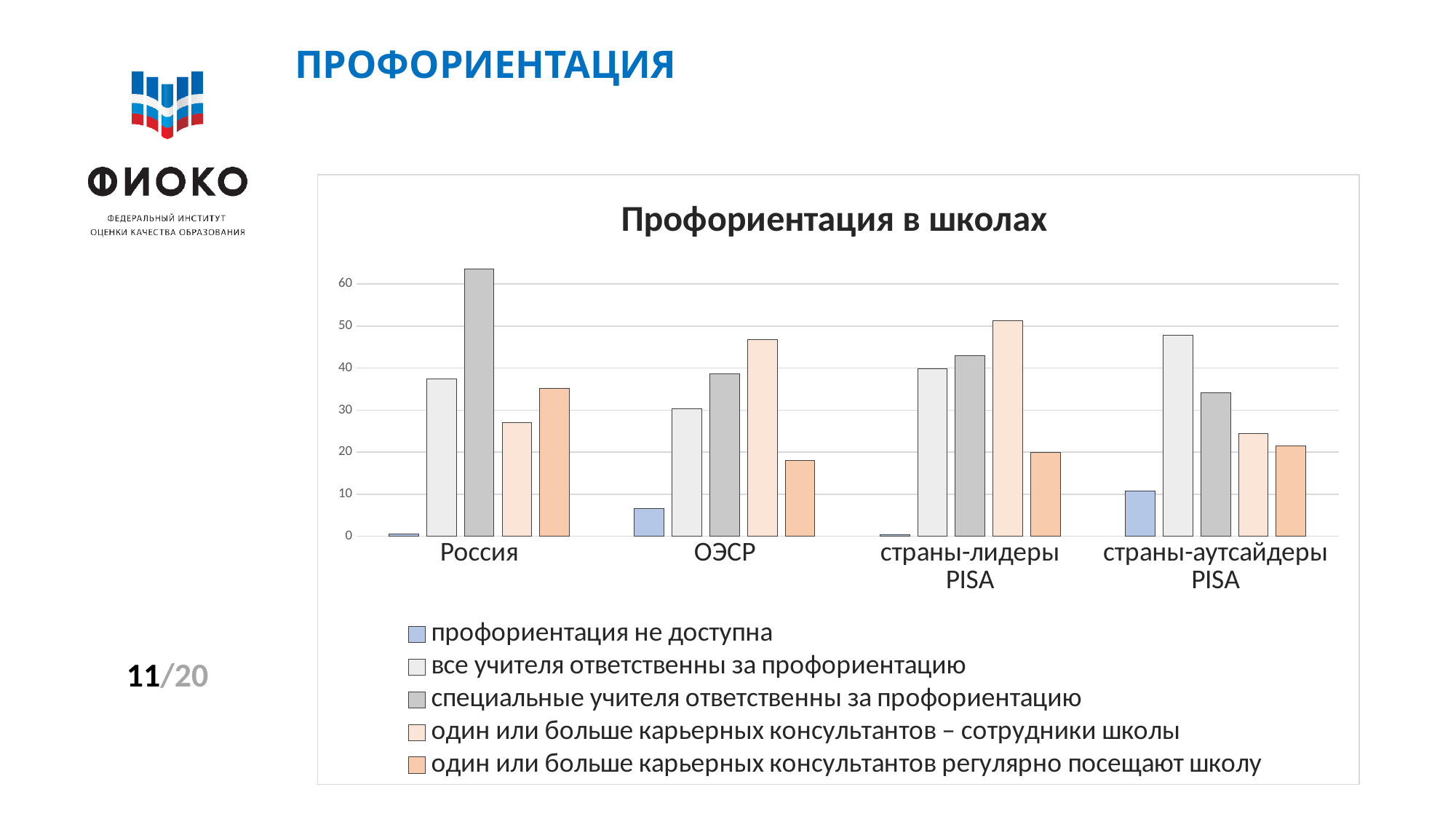
How many categories are shown on the x axis of the chart "Профориентация в школах"? 4 Which category has the highest value for "специальные учителя ответственны за профориентацию"? Россия For "профориентация не доступна", which is larger: Россия or ОЭСР? ОЭСР Which category has the highest value for "один или больше карьерных консультантов регулярно посещают школу"? Россия Which category has the highest value for "профориентация не доступна"? страны-аутсайдеры PISA What is the title of the chart? Профориентация в школах Is the value for "один или больше карьерных консультантов – сотрудники школы" in ОЭСР greater or less than 40? greater How many series does the legend of the chart list? 5 Is the value for "профориентация не доступна" in страны-аутсайдеры PISA greater or less than 20? less Is the value for "специальные учителя ответственны за профориентацию" in Россия greater or less than 60? greater In страны-аутсайдеры PISA, which is larger: "все учителя ответственны за профориентацию" or "специальные учителя ответственны за профориентацию"? все учителя ответственны за профориентацию What kind of chart is shown on the slide? bar chart